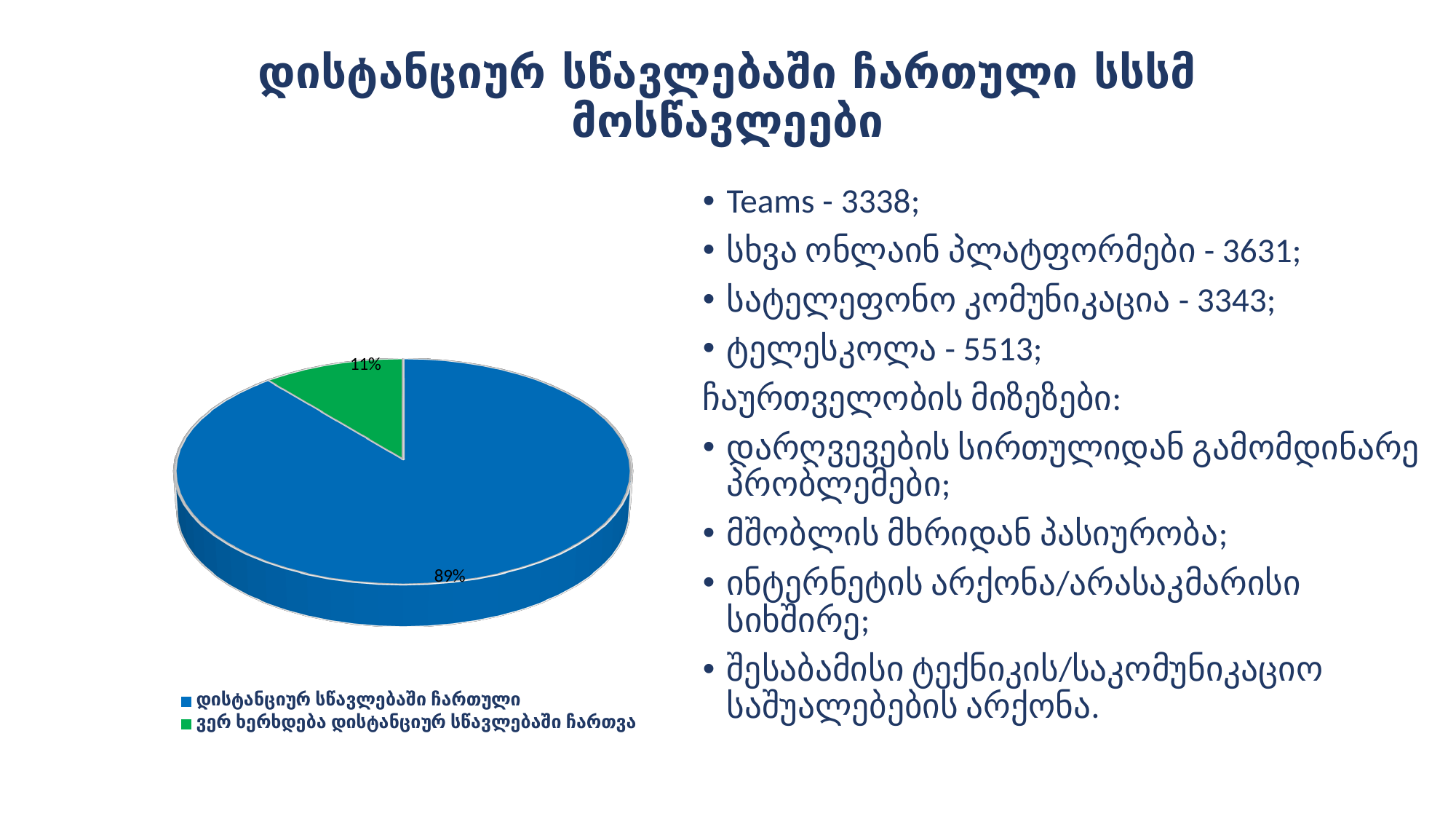
What colour is the slice labelled 89% in the pie chart? blue What share of the pie does the slice "დისტანციურ სწავლებაში ჩართული" represent? 89% What kind of chart is shown on the slide? pie chart What share of the pie does the slice "ვერ ხერხდება დისტანციურ სწავლებაში ჩართვა" represent? 11% How many entries does the legend of the pie chart list? 2 Which slice of the pie chart is the smallest? ვერ ხერხდება დისტანციურ სწავლებაში ჩართვა What colour is the slice labelled 11% in the pie chart? green Which slice of the pie chart is the largest? დისტანციურ სწავლებაში ჩართული Which is larger: the share for "დისტანციურ სწავლებაში ჩართული" or the share for "ვერ ხერხდება დისტანციურ სწავლებაში ჩართვა"? დისტანციურ სწავლებაში ჩართული What is the difference in percentage points between the 89% slice and the 11% slice? 78 How many slices does the pie chart have? 2